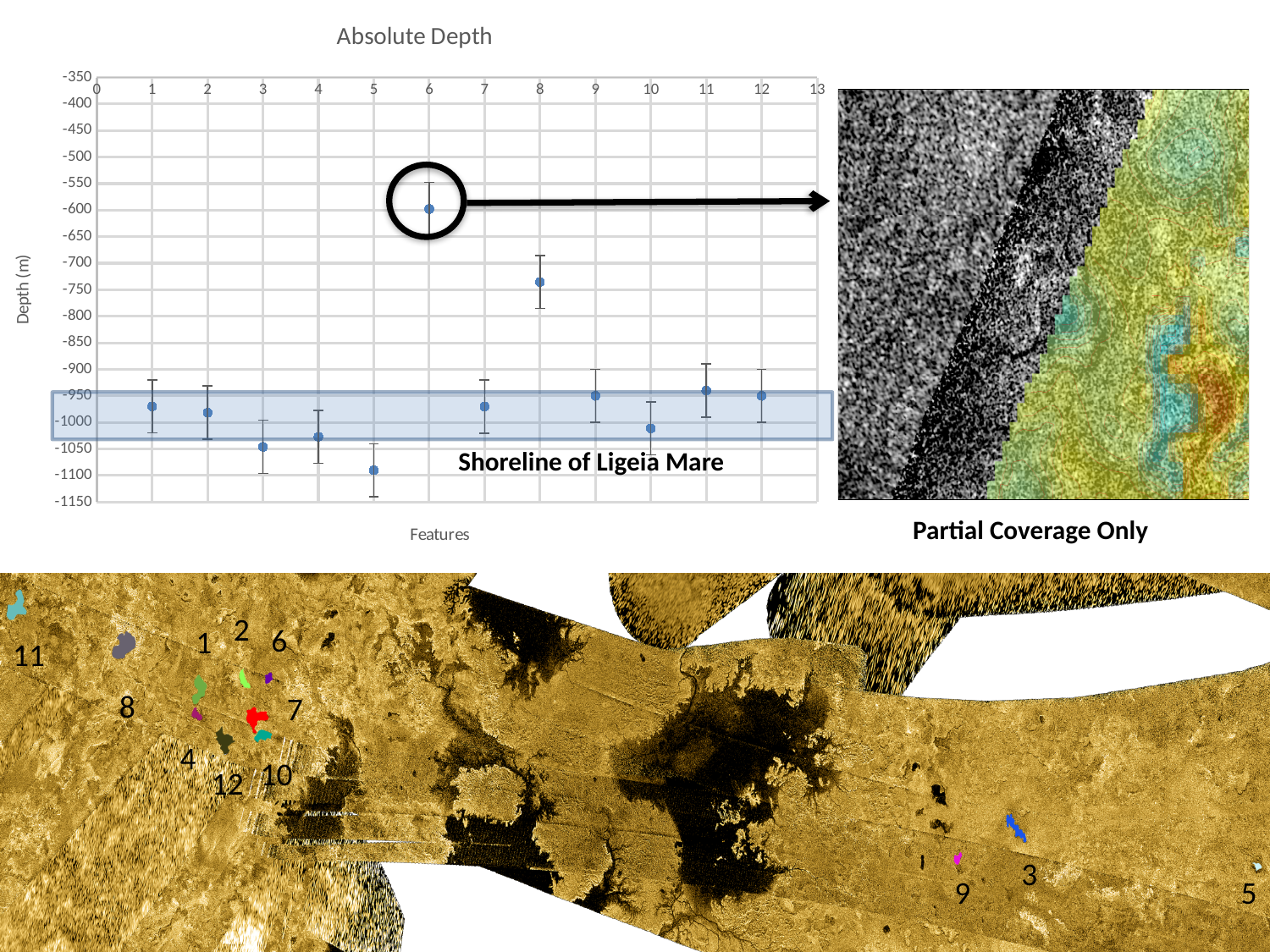
In the 'Absolute Depth' chart, is the depth value for feature 1 greater or less than -1000? greater In the 'Absolute Depth' chart, is the depth value for feature 8 greater or less than -700? less In the 'Absolute Depth' chart, which has the larger depth value, feature 1 or feature 5? feature 1 What is the label of the vertical axis of the 'Absolute Depth' chart? Depth (m) In the 'Absolute Depth' chart, is the depth value for feature 5 greater or less than -1050? less What kind of chart is the 'Absolute Depth' chart? scatter chart In the 'Absolute Depth' chart, which feature has the lowest (deepest) depth value? 5 In the 'Absolute Depth' chart, which feature has the highest (shallowest) depth value? 6 In the 'Absolute Depth' chart, which has the larger depth value, feature 6 or feature 8? feature 6 How many features are plotted as data points in the 'Absolute Depth' chart? 12 What is the title of the chart on the slide? Absolute Depth